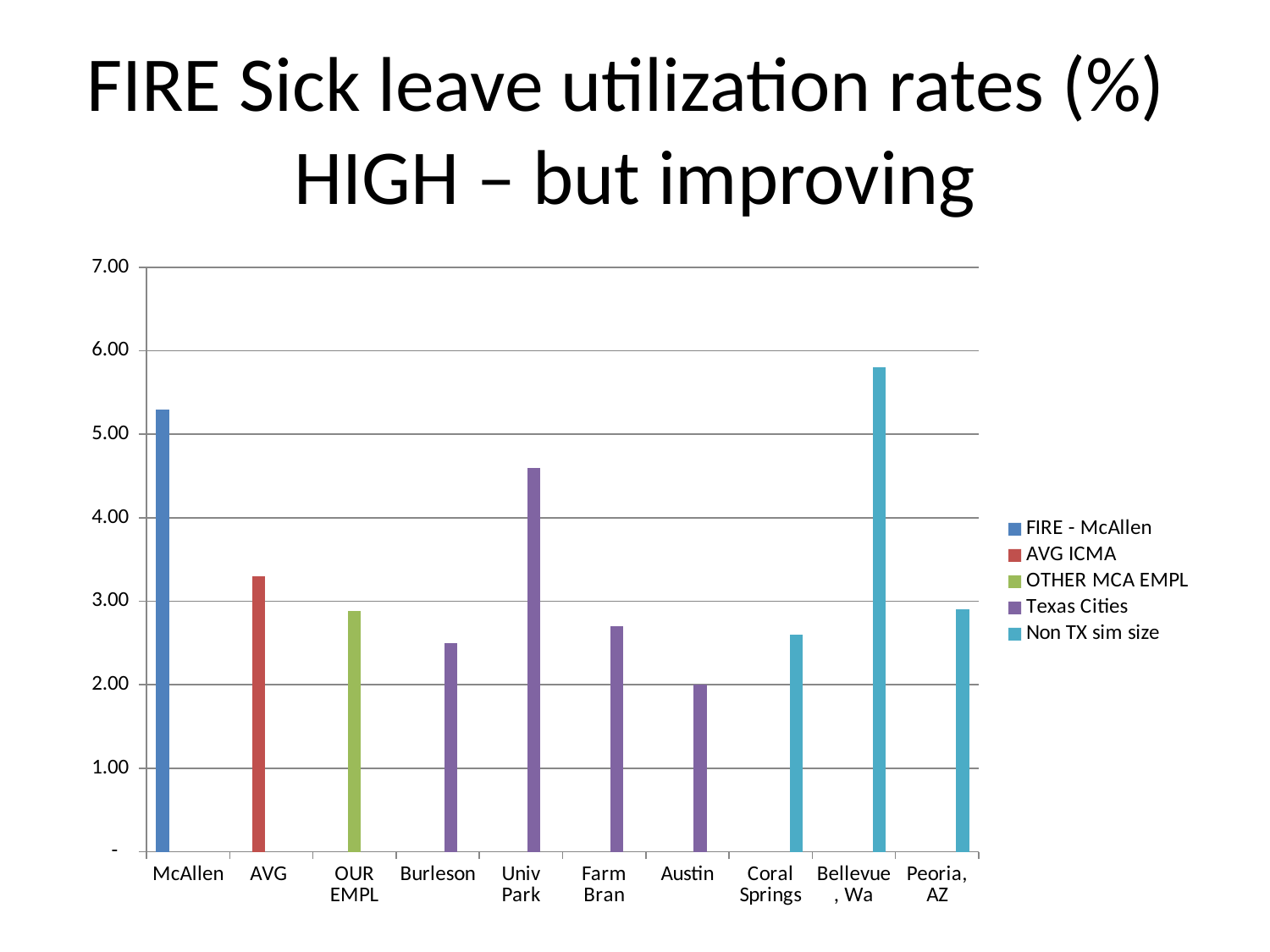
How many series does the legend list? 5 Which category has the lowest sick leave utilization rate? Austin Is the value for McAllen greater or less than 5.00? greater Which category has the highest sick leave utilization rate? Bellevue, Wa Is the value for AVG greater or less than 3.00? greater Which is larger, the value for McAllen or the value for AVG? McAllen Is the value for Univ Park greater or less than 4.00? greater Which is larger, the value for Univ Park or the value for Farm Bran? Univ Park How many categories are shown on the x axis? 10 Which legend series is shown in purple? Texas Cities What kind of chart is shown on the slide? bar chart